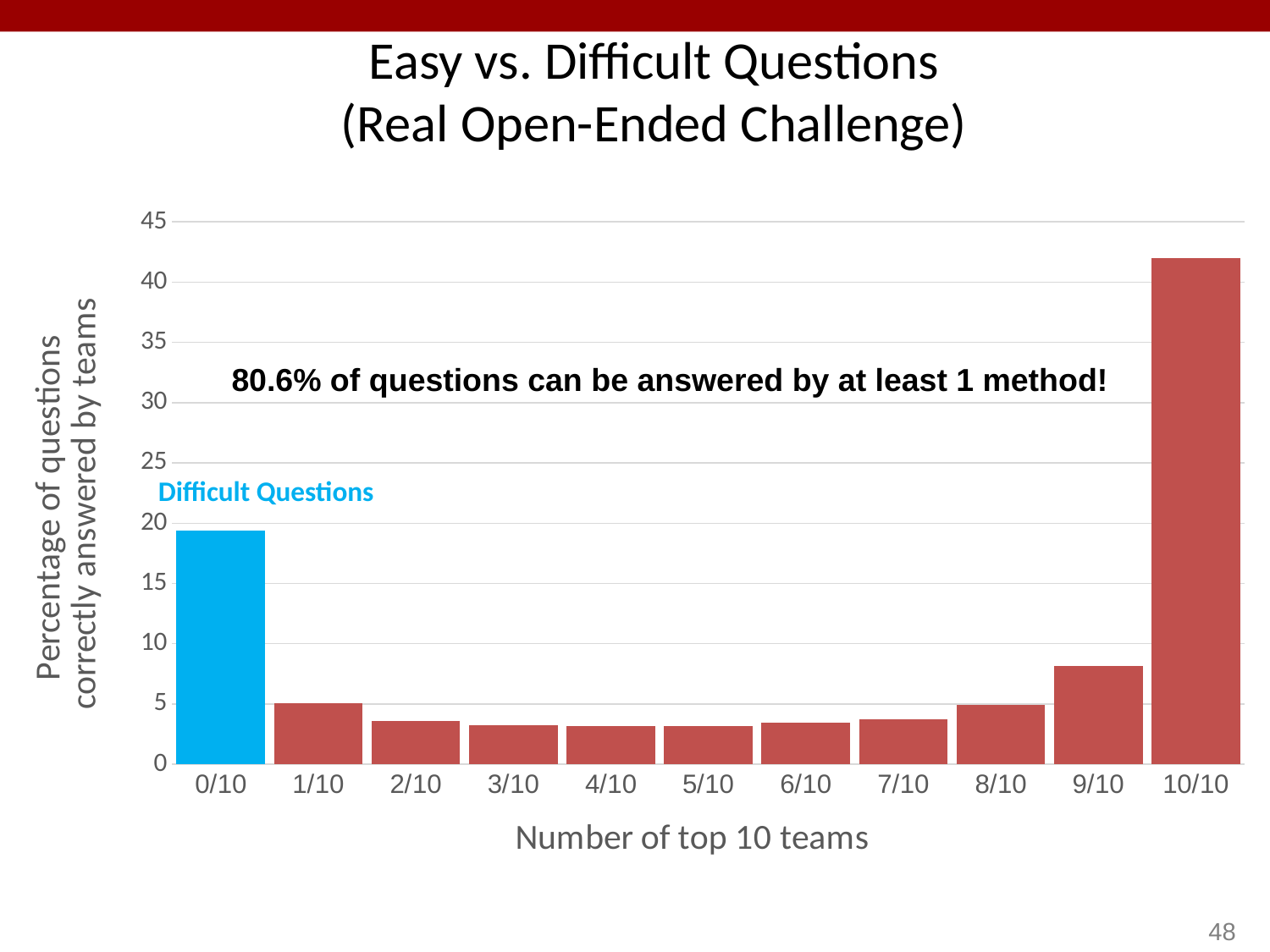
Which category's bar is coloured blue instead of red? 0/10 Is the value for 0/10 greater or less than 20? less Is the value for 2/10 greater or less than 5? less Which has a larger value, 10/10 or 0/10? 10/10 What is the title of the x axis of the chart? Number of top 10 teams Which has a larger value, 0/10 or 9/10? 0/10 Which has a larger value, 9/10 or 1/10? 9/10 Which category has the highest bar in the chart? 10/10 What kind of chart is shown on the slide? Bar chart How many categories are shown on the x axis of the chart? 11 Is the value for 9/10 greater or less than 5? greater